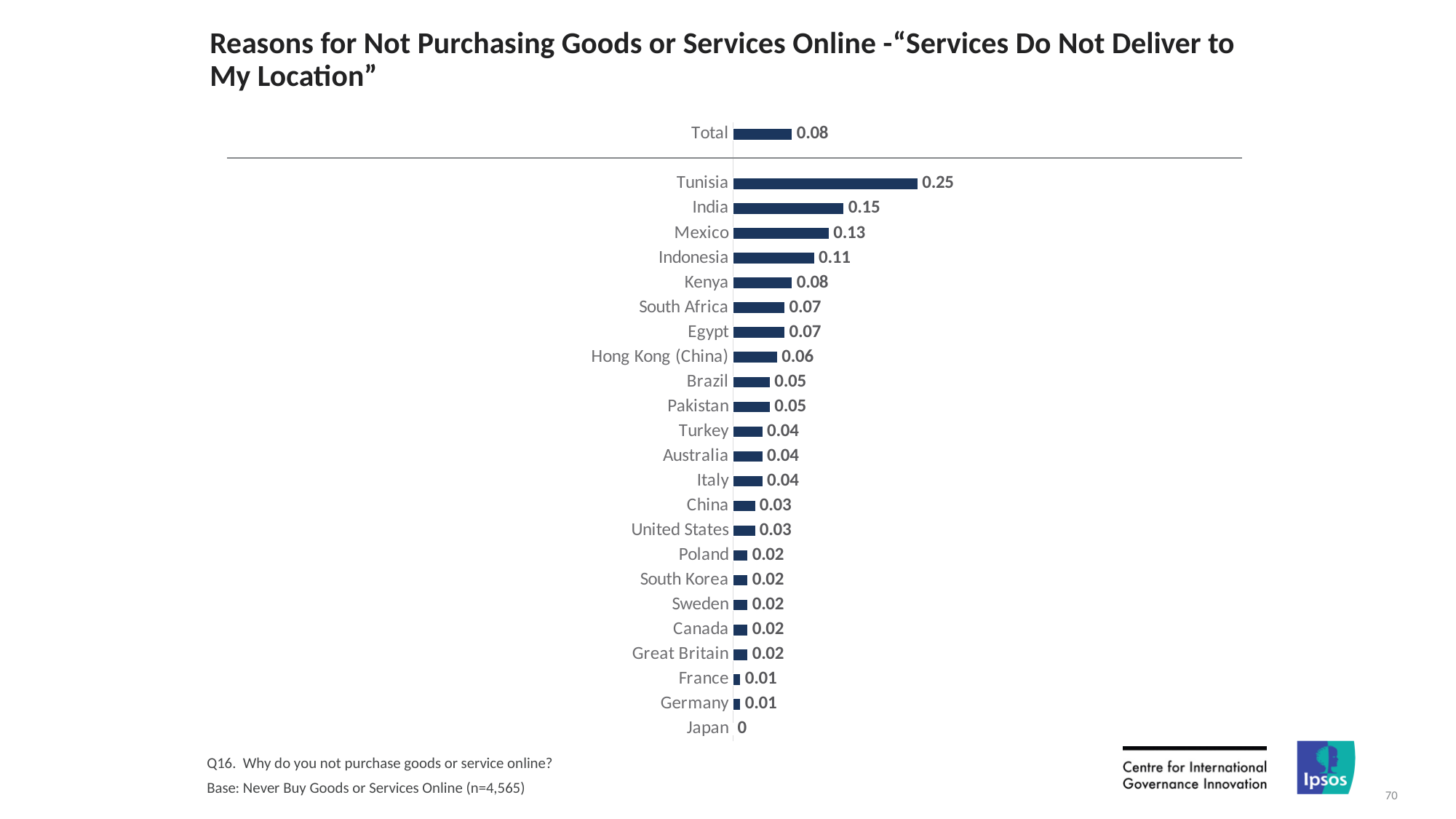
Which country has the highest value? Tunisia Which country has the lowest value? Japan What is the difference between the values for Mexico and Kenya? 0.05 What is the difference between the values for Tunisia and India? 0.10 What is the value for Japan? 0 What is the value for Tunisia? 0.25 How many countries are listed in the chart, excluding Total? 23 Which has a larger value, Indonesia or Egypt? Indonesia What kind of chart is shown on the slide? Bar chart What is the value for Total? 0.08 What is the value for Hong Kong (China)? 0.06 What is the base sample size (n) stated at the bottom of the slide? 4,565